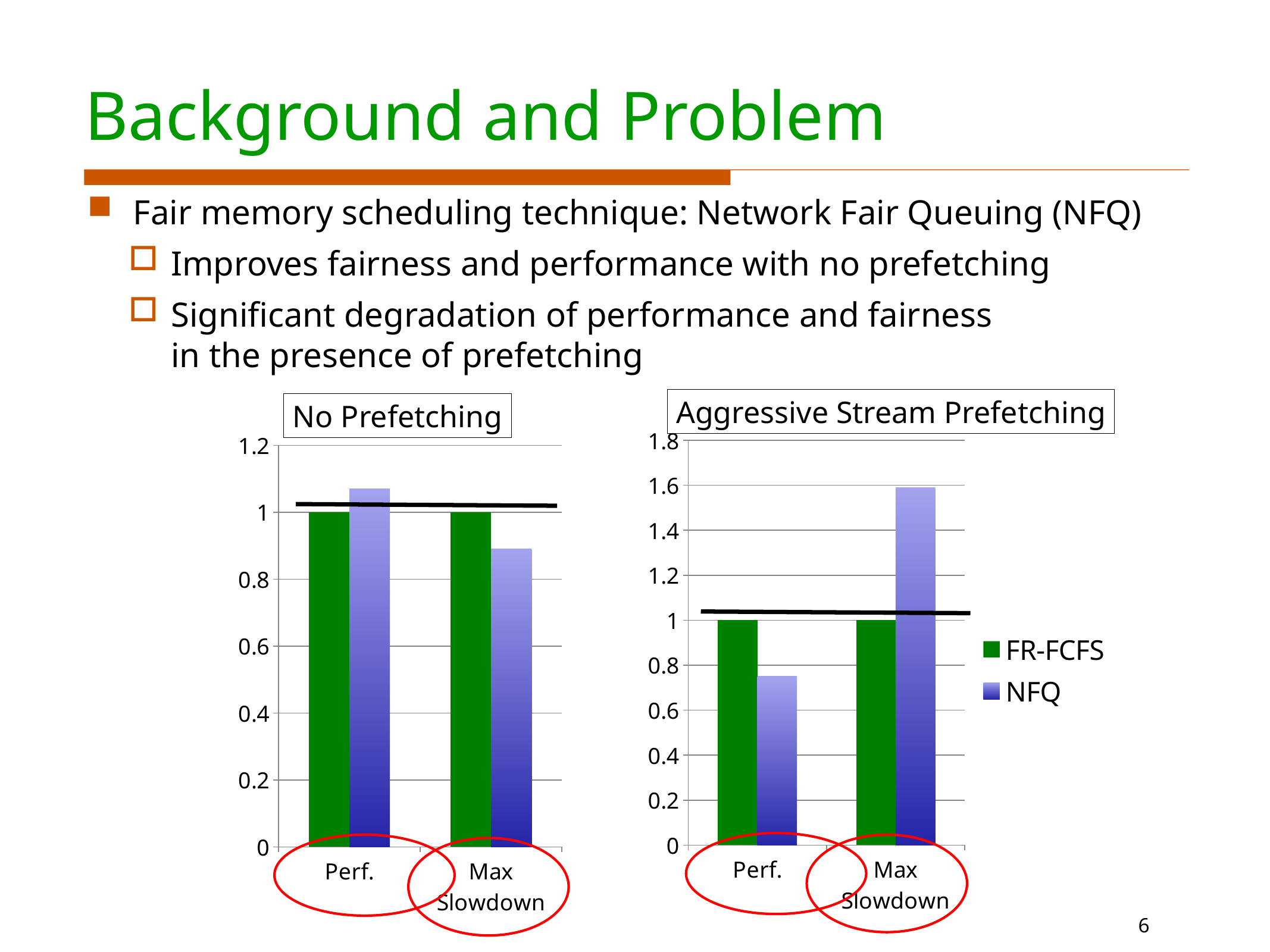
In the "Aggressive Stream Prefetching" chart, is the NFQ value for Max Slowdown greater or less than 1.4? greater In the "No Prefetching" chart, what is the FR-FCFS value for Perf.? 1 How many categories are shown on the x axis of the "Aggressive Stream Prefetching" chart? 2 Which series is shown in green in the legend? FR-FCFS How many series does the legend list for the charts? 2 In the "Aggressive Stream Prefetching" chart, which is larger for Perf., FR-FCFS or NFQ? FR-FCFS In the "Aggressive Stream Prefetching" chart, what is the FR-FCFS value for Max Slowdown? 1 In the "No Prefetching" chart, is the NFQ value for Perf. greater or less than 1? greater In the "No Prefetching" chart, is the NFQ value for Max Slowdown greater or less than 1? less What kind of chart is the "No Prefetching" chart? bar chart In the "Aggressive Stream Prefetching" chart, which bar is the tallest? NFQ for Max Slowdown